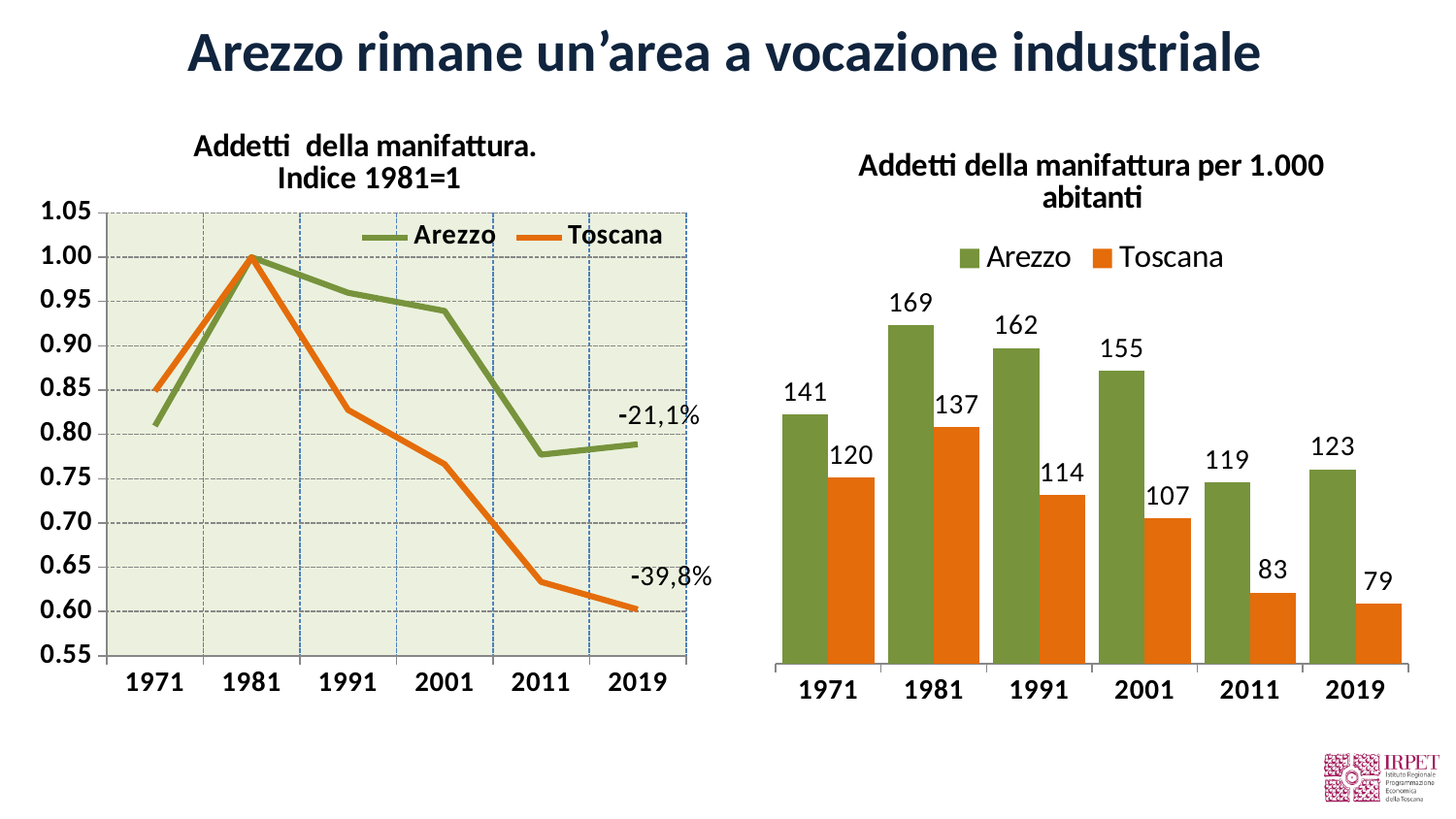
In the chart 'Addetti della manifattura per 1.000 abitanti', which year has the lowest value for Toscana? 2019 In the chart 'Addetti della manifattura per 1.000 abitanti', what is the value for Arezzo in 1981? 169 How many series does the legend of the chart 'Addetti della manifattura. Indice 1981=1' list? 2 In the chart 'Addetti della manifattura per 1.000 abitanti', what is the difference between Arezzo and Toscana in 2001? 48 In the chart 'Addetti della manifattura per 1.000 abitanti', what is the value for Toscana in 2019? 79 In the chart 'Addetti della manifattura per 1.000 abitanti', which is larger in 2011: Arezzo or Toscana? Arezzo In the chart 'Addetti della manifattura. Indice 1981=1', what percentage change is annotated next to the Toscana line at 2019? -39,8% What kind of chart is 'Addetti della manifattura per 1.000 abitanti'? Bar chart In the chart 'Addetti della manifattura. Indice 1981=1', is the value for Arezzo in 2001 greater or less than 0.90? greater How many years are shown on the x axis of the chart 'Addetti della manifattura per 1.000 abitanti'? 6 In the chart 'Addetti della manifattura per 1.000 abitanti', which year has the highest value for Arezzo? 1981 In the chart 'Addetti della manifattura. Indice 1981=1', is the value for Toscana in 2019 greater or less than 0.65? less